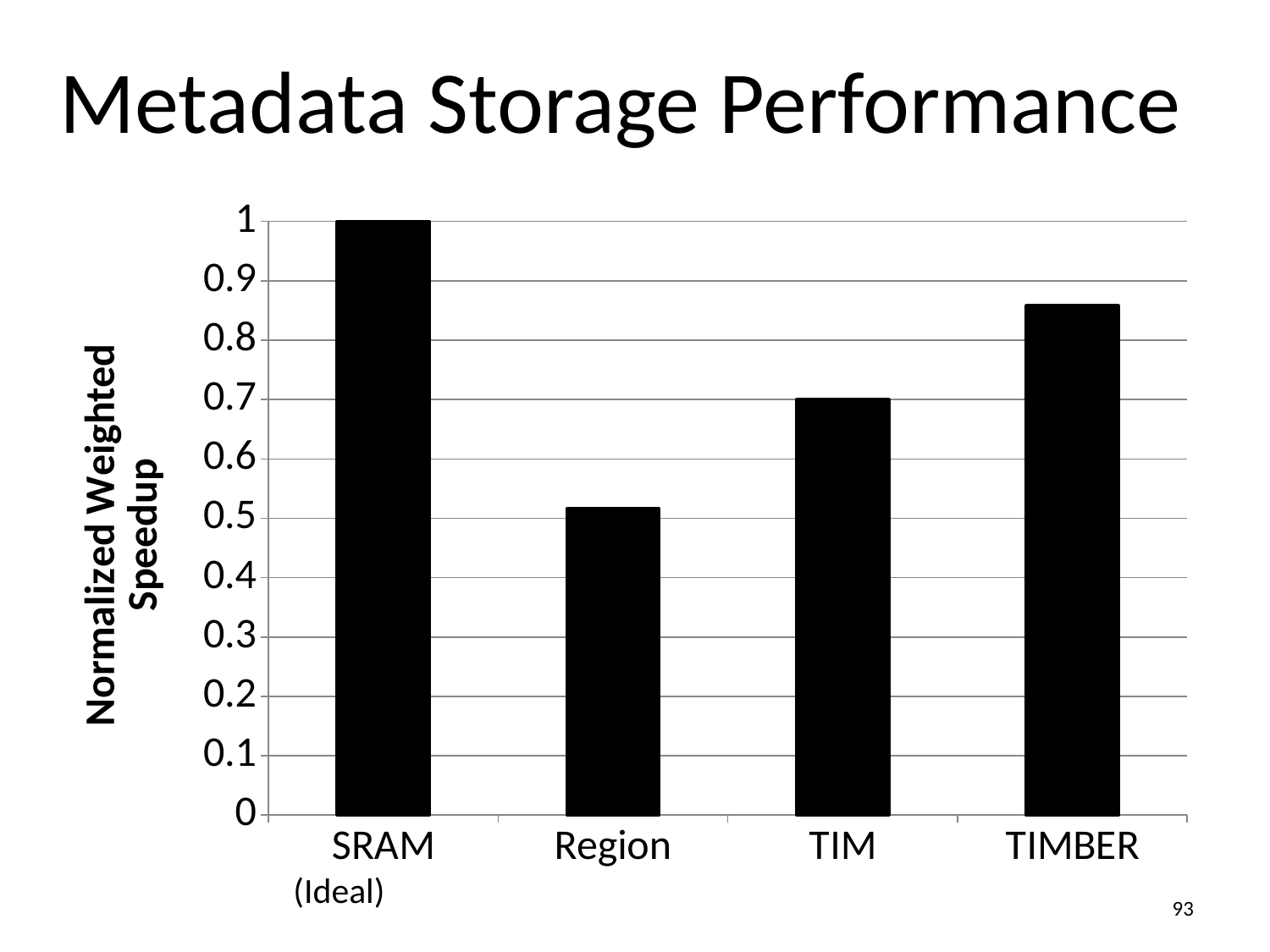
Which category has the highest normalized weighted speedup? SRAM (Ideal) Is the value for TIMBER greater or less than 0.8? greater Which has a larger normalized weighted speedup, Region or TIM? TIM Which category has the lowest normalized weighted speedup? Region Is the value for TIM greater or less than 0.6? greater What is the normalized weighted speedup for SRAM (Ideal)? 1 What is the label of the y axis? Normalized Weighted Speedup Is the value for TIMBER greater or less than 0.9? less How many categories are plotted on the x axis? 4 What kind of chart is shown on the slide? bar chart Which has a larger normalized weighted speedup, TIM or TIMBER? TIMBER